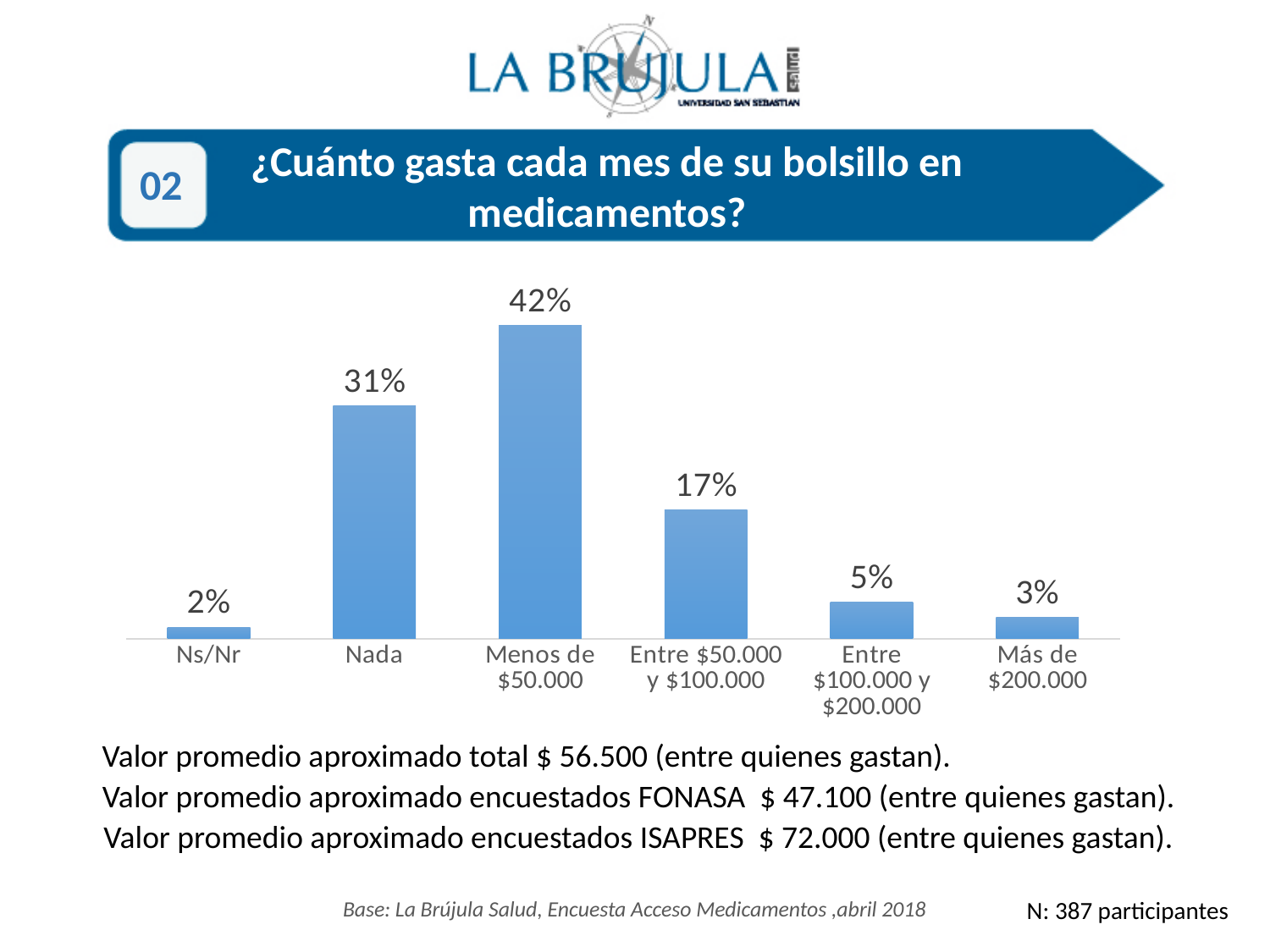
What is the question number shown in the title box of the slide? 02 Which category has the lowest value? Ns/Nr What is the difference between the values for "Entre $50.000 y $100.000" and "Entre $100.000 y $200.000"? 12% How many categories are shown on the x axis? 6 What is the value for "Más de $200.000"? 3% What percentage is shown for "Entre $50.000 y $100.000"? 17% What percentage of respondents answered "Nada"? 31% What is the value for "Menos de $50.000"? 42% Which is larger, the value for "Entre $100.000 y $200.000" or the value for "Más de $200.000"? Entre $100.000 y $200.000 Which category has the highest value? Menos de $50.000 What kind of chart is shown on the slide? Bar chart What is the difference between the values for "Menos de $50.000" and "Nada"? 11%